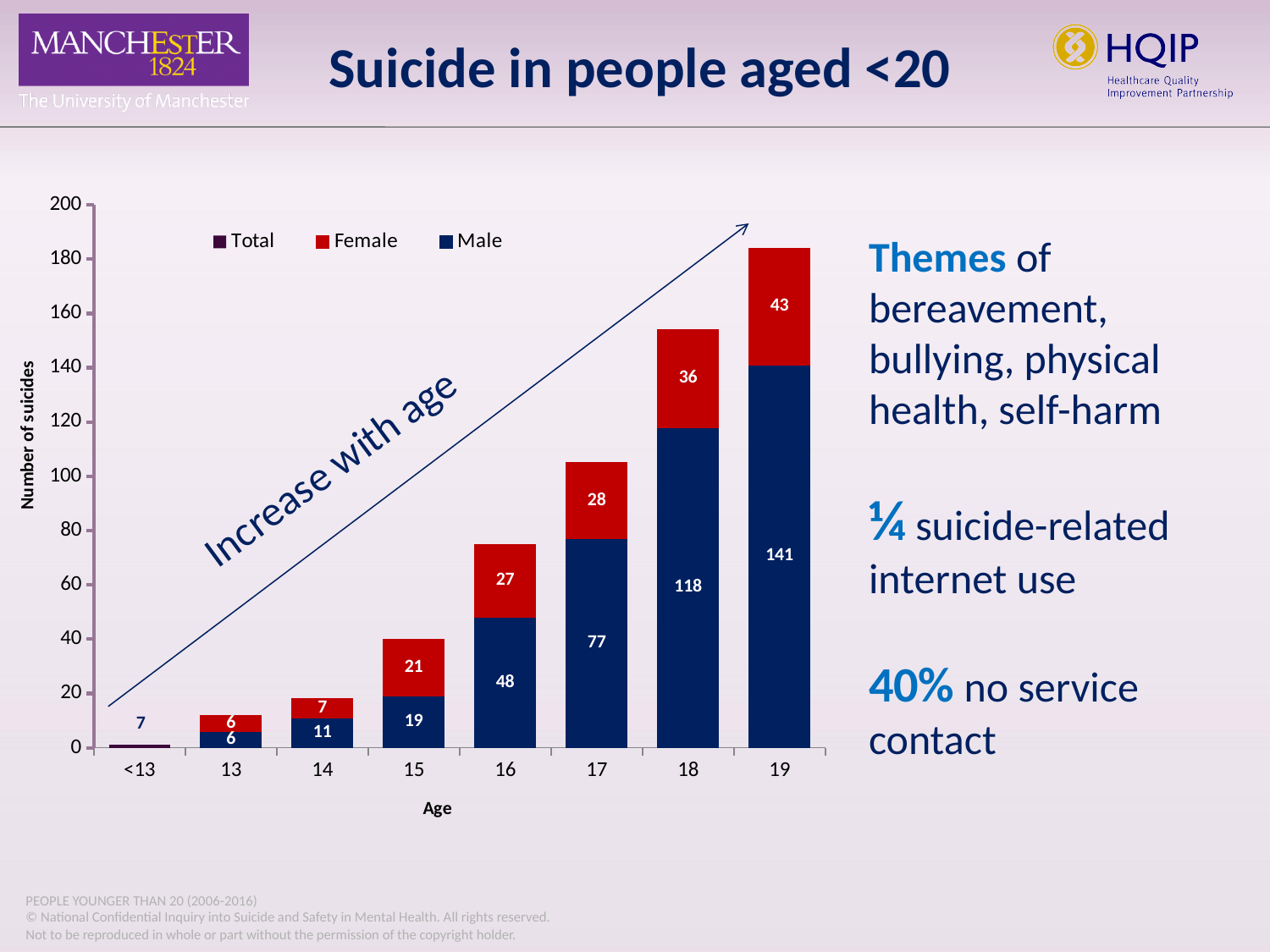
What kind of chart is shown on the slide? Stacked bar chart How many series does the legend list? 3 What is the total of the stacked bar for age 17? 105 Which is larger for age 15, the Male value or the Female value? Female What is the Male value for age 16? 48 Which age group has the lowest Female value? 13 What is the difference between the Male values for age 19 and age 18? 23 How many age categories are shown on the x axis? 8 What is the Female value for age 18? 36 What is the Female value for age 15? 21 Which age group has the highest Male value? 19 What is the Male value for age 19? 141